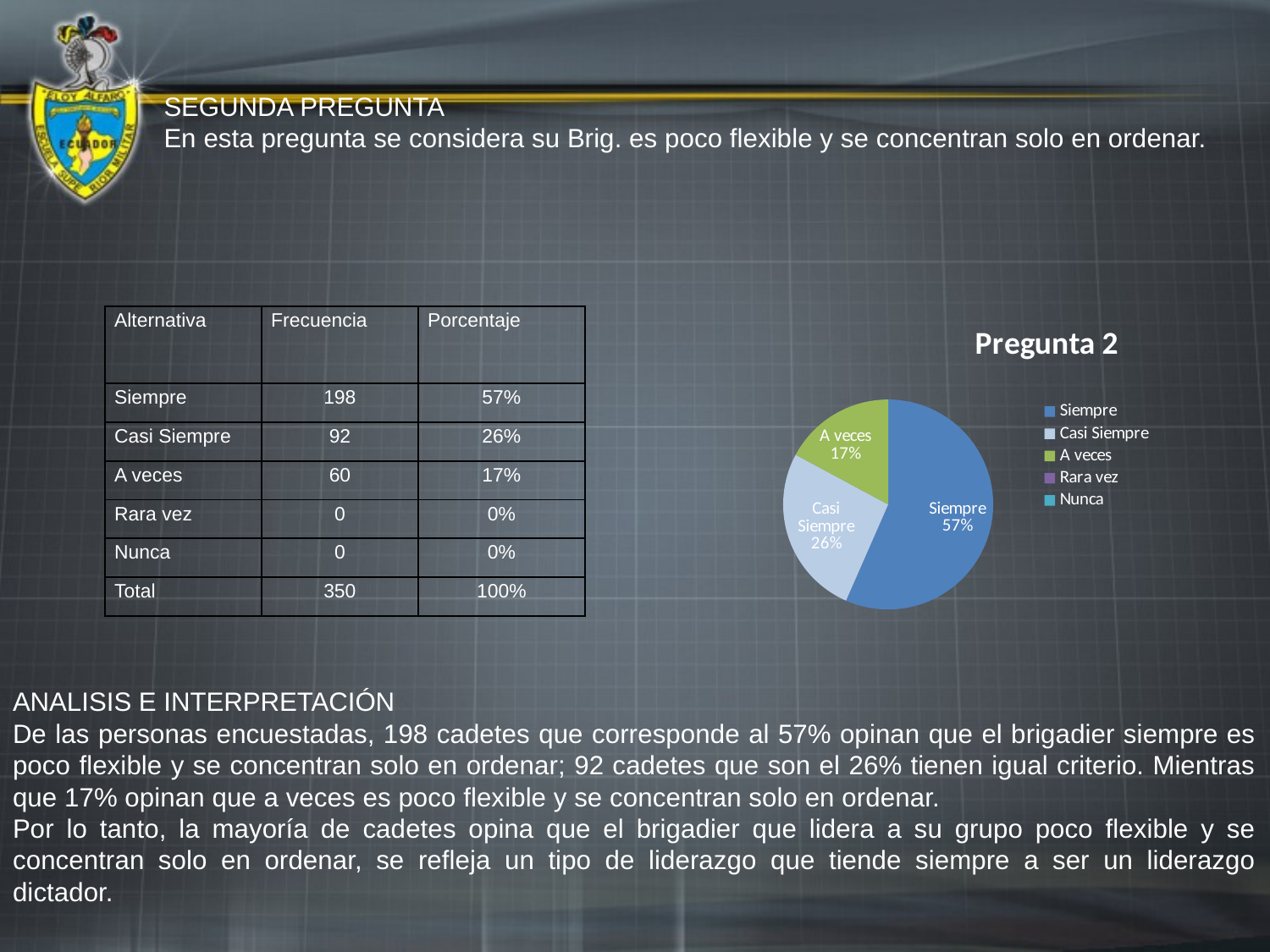
Which category has the largest slice in the pie chart? Siempre Which of the labelled slices is the smallest in the pie chart? A veces How many entries does the legend of the pie chart list? 5 What percentage does the Siempre slice show in the pie chart? 57% What is the difference in percentage points between the Siempre and Casi Siempre slices? 31% What percentage does the A veces slice show in the pie chart? 17% What kind of chart is shown on the slide? pie chart What colour is the Siempre slice in the pie chart? blue Which slice is larger, Casi Siempre or A veces? Casi Siempre What percentage does the Casi Siempre slice show in the pie chart? 26% What is the title of the chart? Pregunta 2 Is the Siempre slice greater or less than 50% of the pie? greater